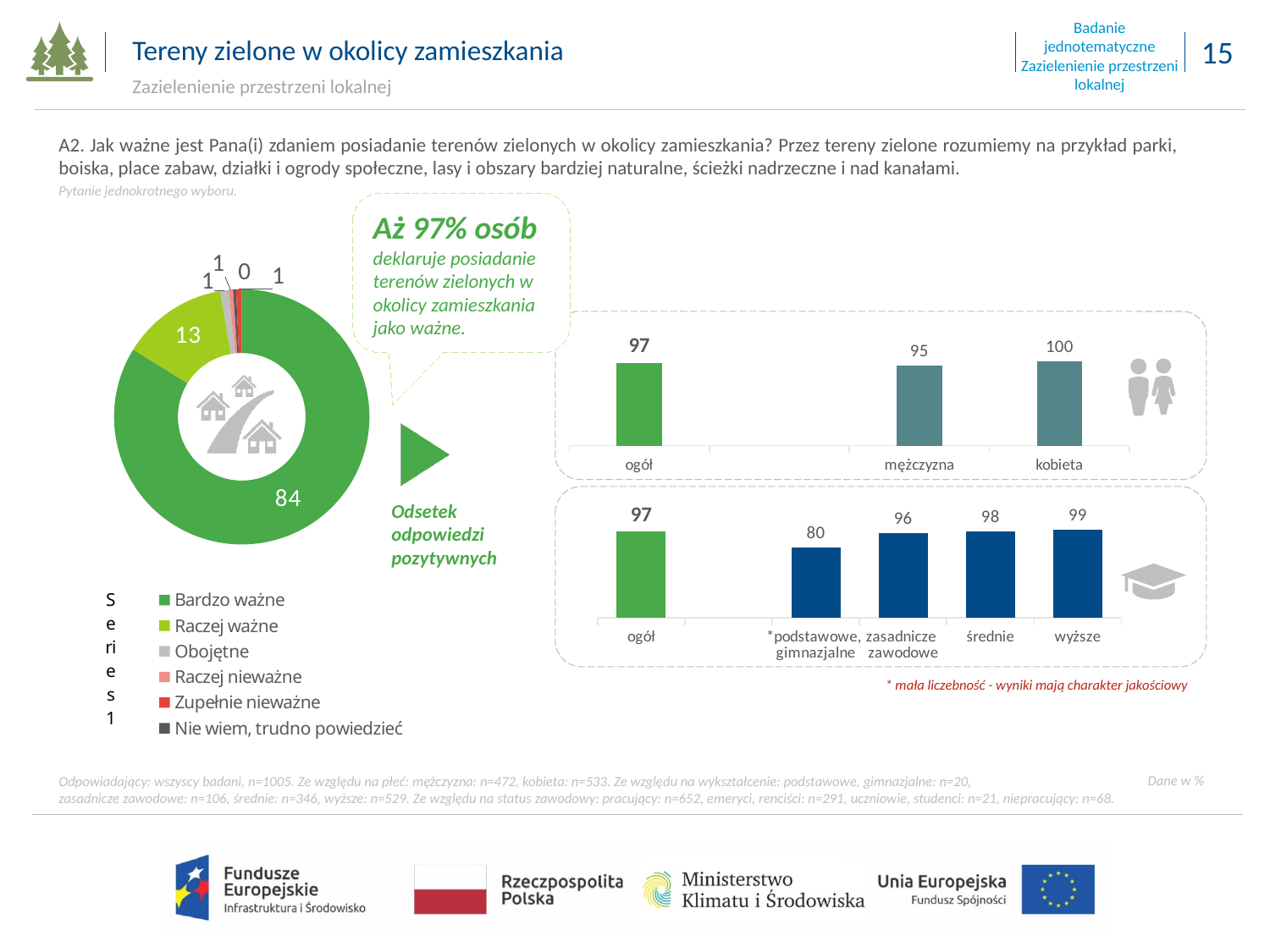
In the doughnut chart on the left, which answer category has the largest share? Bardzo ważne In the top-right bar chart (by gender), what is the value for "kobieta"? 100 In the doughnut chart on the left, what percentage of respondents answered "Bardzo ważne"? 84 In the top-right bar chart (by gender), which category has the lowest value? mężczyzna In the doughnut chart on the left, what is the difference between the values for "Bardzo ważne" and "Raczej ważne"? 71 In the top-right bar chart (by gender), what is the value for "mężczyzna"? 95 How many entries does the legend of the doughnut chart on the left list? 6 In the doughnut chart on the left, what value is shown for "Raczej ważne"? 13 In the bottom-right bar chart (by education), what is the difference between the values for "ogół" and "podstawowe, gimnazjalne"? 17 In the bottom-right bar chart (by education), which category has the lowest value? podstawowe, gimnazjalne In the bottom-right bar chart (by education), how many bars are shown? 5 In the bottom-right bar chart (by education), what is the value for "wyższe"? 99